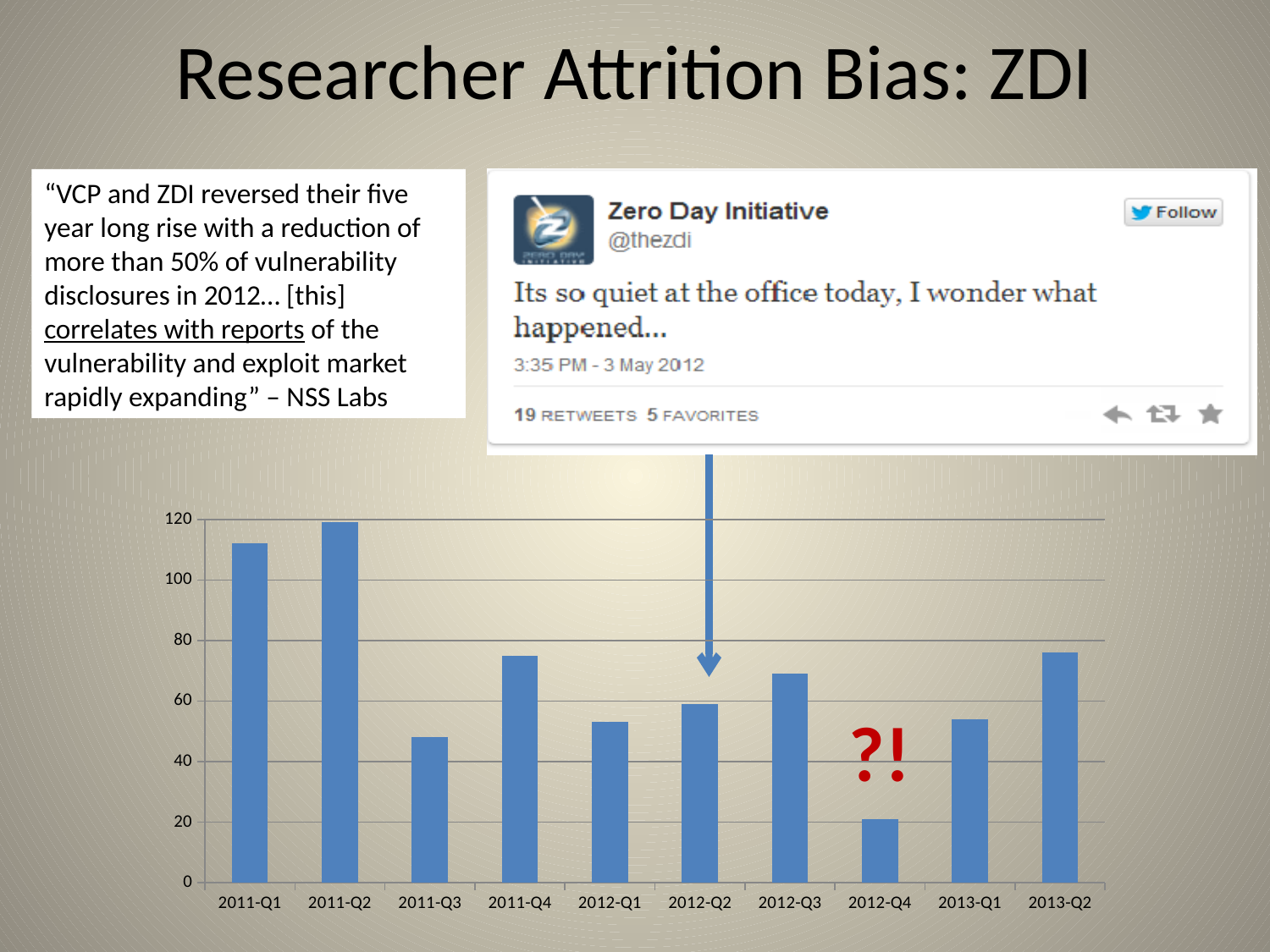
Which quarter has the highest bar in the chart? 2011-Q2 Is the value for 2012-Q3 greater or less than 60? greater Is the value for 2012-Q4 greater or less than 40? less How many quarters are plotted on the x axis of the chart? 10 Is the value for 2011-Q3 greater or less than 60? less What kind of chart is shown on the slide? bar chart Which is larger, the value for 2012-Q1 or the value for 2012-Q3? 2012-Q3 Which is larger, the value for 2011-Q2 or the value for 2011-Q4? 2011-Q2 Do the values rise or fall from 2011-Q2 to 2011-Q3? fall Which quarter has the lowest bar in the chart? 2012-Q4 What is the highest tick value shown on the y axis of the chart? 120